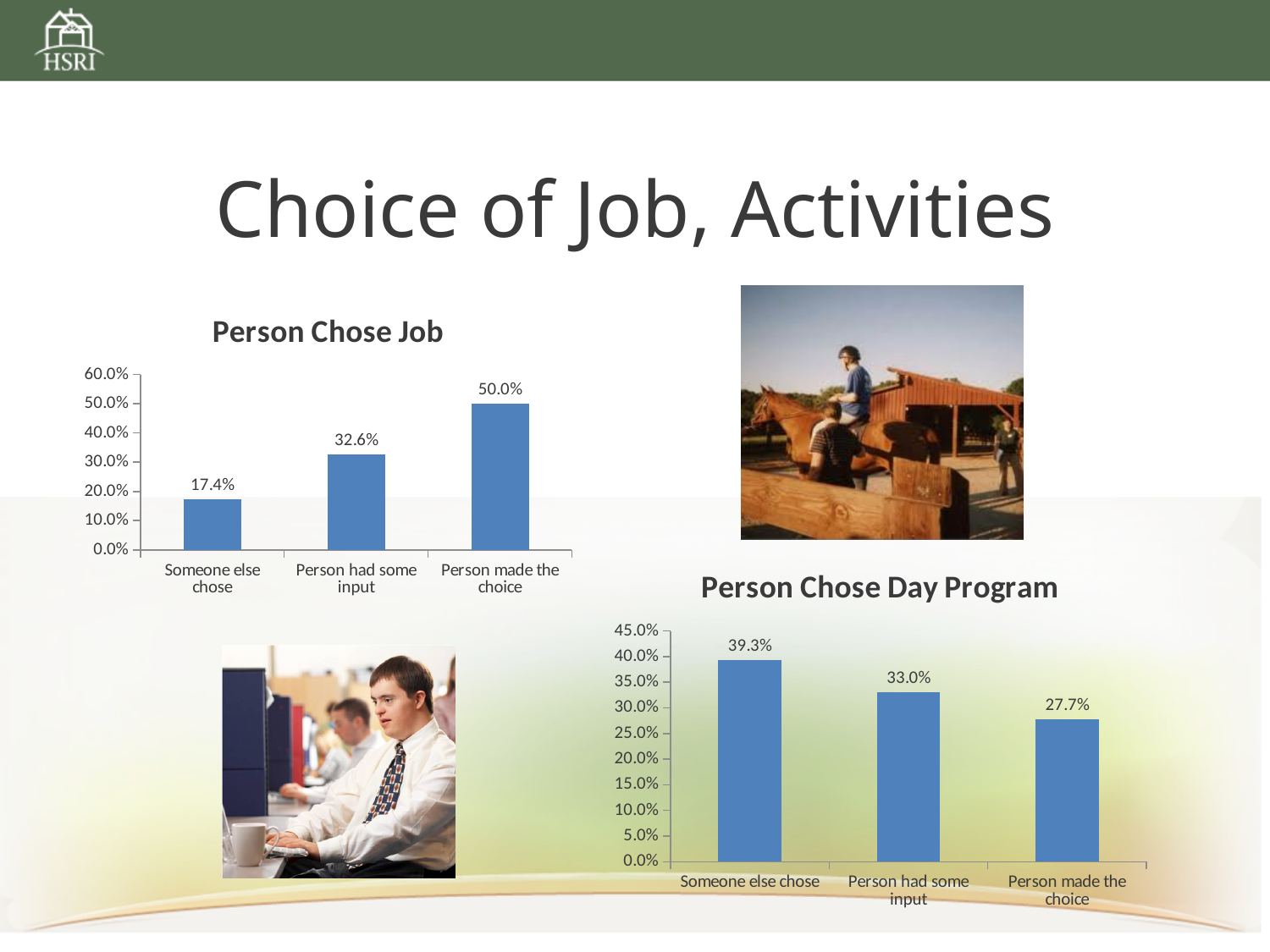
In the 'Person Chose Day Program' chart, what is the value for 'Person made the choice'? 27.7% In the 'Person Chose Day Program' chart, what is the value for 'Person had some input'? 33.0% In the 'Person Chose Job' chart, what is the difference between 'Person made the choice' and 'Someone else chose'? 32.6% In the 'Person Chose Job' chart, which category has the highest value? Person made the choice In the 'Person Chose Day Program' chart, which category has the highest value? Someone else chose In the 'Person Chose Job' chart, what is the value for 'Someone else chose'? 17.4% In the 'Person Chose Job' chart, what is the value for 'Person made the choice'? 50.0% In the 'Person Chose Day Program' chart, what is the difference between 'Someone else chose' and 'Person made the choice'? 11.6% How many categories does the 'Person Chose Day Program' chart show? 3 In the 'Person Chose Job' chart, do the values rise or fall from left to right? rise Which is larger: 'Person had some input' in the 'Person Chose Job' chart or 'Person had some input' in the 'Person Chose Day Program' chart? Person Chose Day Program In the 'Person Chose Day Program' chart, which category has the lowest value? Person made the choice